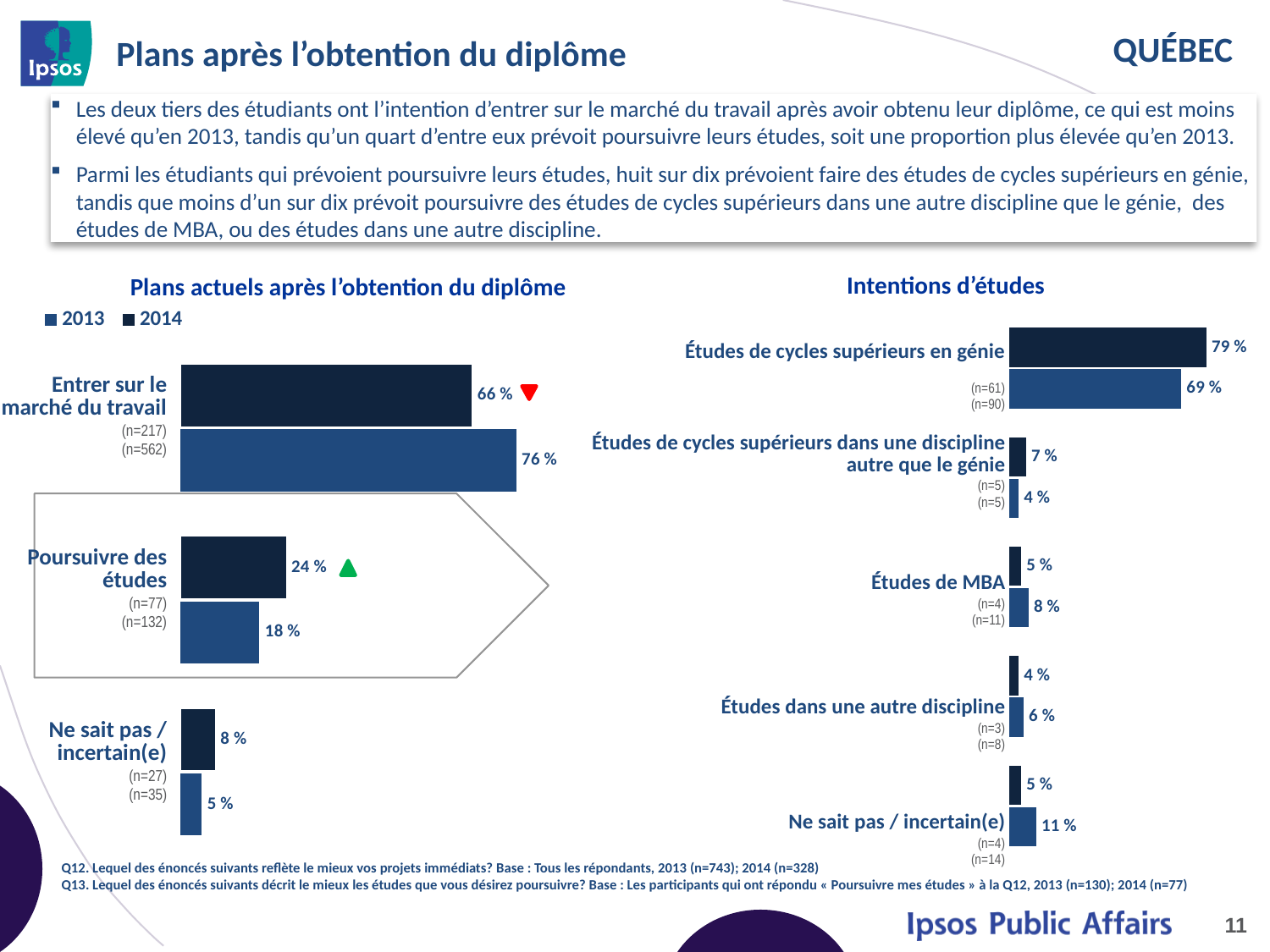
How many categories are shown in the 'Intentions d'études' chart? 5 In the 'Intentions d'études' chart, is the larger value for 'Études de MBA' greater than the larger value for 'Études dans une autre discipline'? Yes In the 'Plans actuels après l'obtention du diplôme' chart, what is the difference between the two values shown for 'Entrer sur le marché du travail'? 10 percentage points In the 'Intentions d'études' chart, what is the larger of the two values shown for 'Études de cycles supérieurs en génie'? 79 % What kind of chart is 'Plans actuels après l'obtention du diplôme'? Bar chart In the 'Intentions d'études' chart, what is the larger of the two values shown for 'Ne sait pas / incertain(e)'? 11 % In the 'Plans actuels après l'obtention du diplôme' chart, what is the larger of the two values shown for 'Entrer sur le marché du travail'? 76 % How many categories are shown in the 'Plans actuels après l'obtention du diplôme' chart? 3 In the 'Plans actuels après l'obtention du diplôme' chart, what is the smaller of the two values shown for 'Poursuivre des études'? 18 % In the 'Plans actuels après l'obtention du diplôme' chart, which category has the lowest values? Ne sait pas / incertain(e) How many series does the legend of the 'Plans actuels après l'obtention du diplôme' chart list? 2 In the 'Intentions d'études' chart, which category has the highest value? Études de cycles supérieurs en génie